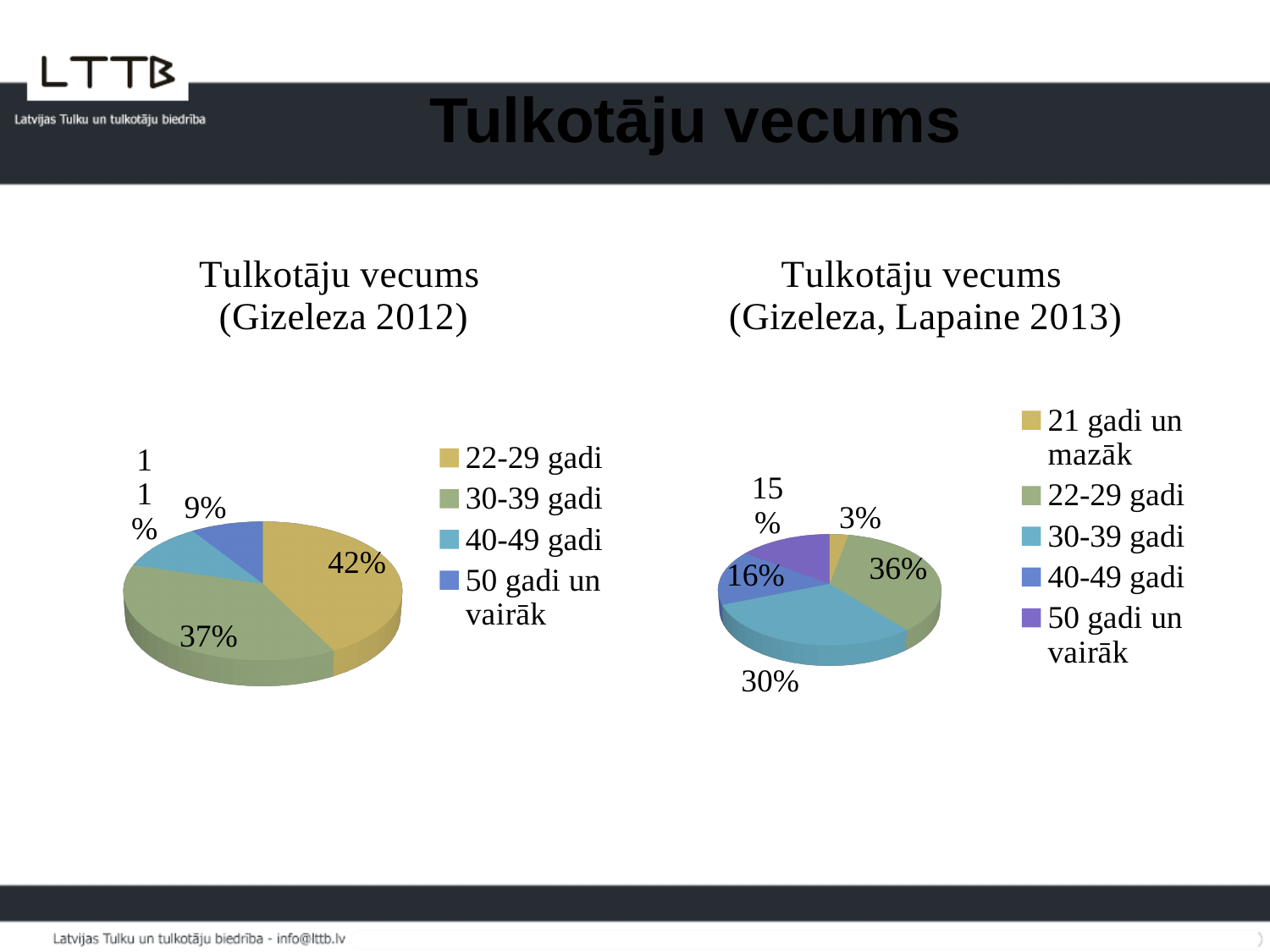
In the chart titled 'Tulkotāju vecums (Gizeleza 2012)', what percentage is shown for '50 gadi un vairāk'? 9% In the chart titled 'Tulkotāju vecums (Gizeleza 2012)', how many slices does the pie have? 4 In the chart titled 'Tulkotāju vecums (Gizeleza, Lapaine 2013)', what is the difference in percentage points between '22-29 gadi' and '30-39 gadi'? 6 In the chart titled 'Tulkotāju vecums (Gizeleza 2012)', which age group has the largest slice? 22-29 gadi In the chart titled 'Tulkotāju vecums (Gizeleza 2012)', which is larger, the '40-49 gadi' slice or the '50 gadi un vairāk' slice? 40-49 gadi In the chart titled 'Tulkotāju vecums (Gizeleza, Lapaine 2013)', how many categories does the legend list? 5 What kind of chart is the one titled 'Tulkotāju vecums (Gizeleza, Lapaine 2013)'? Pie chart In the chart titled 'Tulkotāju vecums (Gizeleza, Lapaine 2013)', what percentage is shown for '30-39 gadi'? 30% In the chart titled 'Tulkotāju vecums (Gizeleza, Lapaine 2013)', what percentage is shown for '22-29 gadi'? 36% In the chart titled 'Tulkotāju vecums (Gizeleza 2012)', what percentage is shown for '30-39 gadi'? 37% In the chart titled 'Tulkotāju vecums (Gizeleza 2012)', what share of the pie is the '22-29 gadi' slice? 42% In the chart titled 'Tulkotāju vecums (Gizeleza, Lapaine 2013)', which age group has the smallest slice? 21 gadi un mazāk